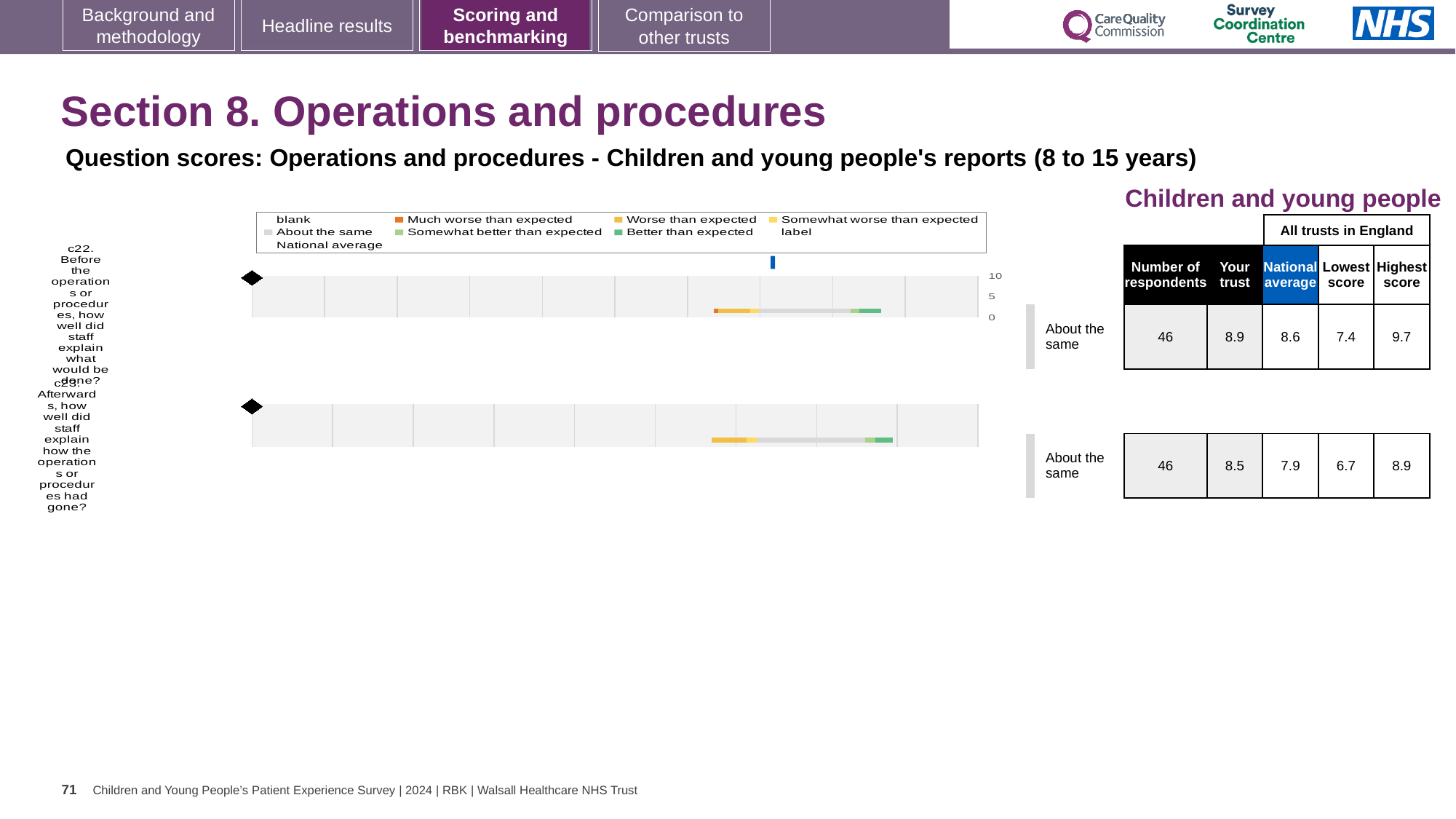
According to the table beside the chart, what is the national average score for c23 (Afterwards, how well did staff explain how the operations or procedures had gone)? 7.9 Which question has the higher 'Your trust' score, c22 or c23? c22 What benchmark category is shown for c22 next to the chart? About the same What is the lowest score among all trusts in England for c23? 6.7 According to the table beside the chart, what is the 'Your trust' score for c22 (Before the operations or procedures, how well did staff explain what would be done)? 8.9 How many respondents answered question c23? 46 By how much does the trust's score for c22 exceed the national average for c22? 0.3 In the chart legend, what colour represents 'Much worse than expected'? orange By how much does the trust's score for c23 exceed the national average for c23? 0.6 How many survey questions (rows) are plotted on the slide? 2 What is the highest score among all trusts in England for c22? 9.7 What kind of chart is used to show the question scores for c22 and c23? bar chart